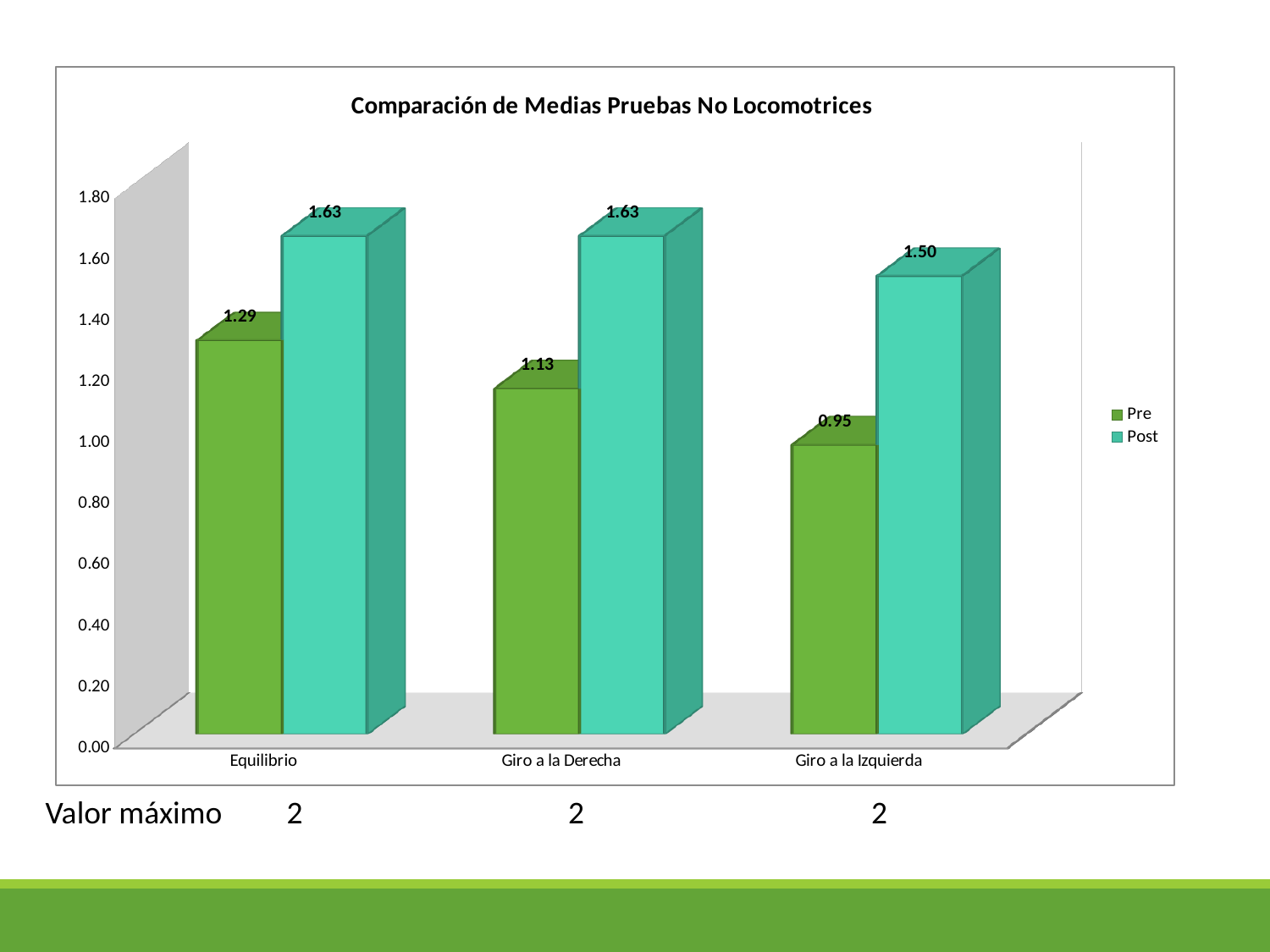
What is the title of the chart? Comparación de Medias Pruebas No Locomotrices What is the Post value for Giro a la Izquierda? 1.50 What is the Pre value for Giro a la Derecha? 1.13 What kind of chart is shown on the slide? Bar chart How many series does the legend list? 2 Which is larger for Equilibrio, the Pre value or the Post value? Post What is the Pre value for Equilibrio? 1.29 How many categories are shown on the x axis? 3 Which category has the highest Pre value? Equilibrio What is the difference between the Post and Pre values for Giro a la Izquierda? 0.55 What is the difference between the Post and Pre values for Giro a la Derecha? 0.50 Which category has the lowest Pre value? Giro a la Izquierda